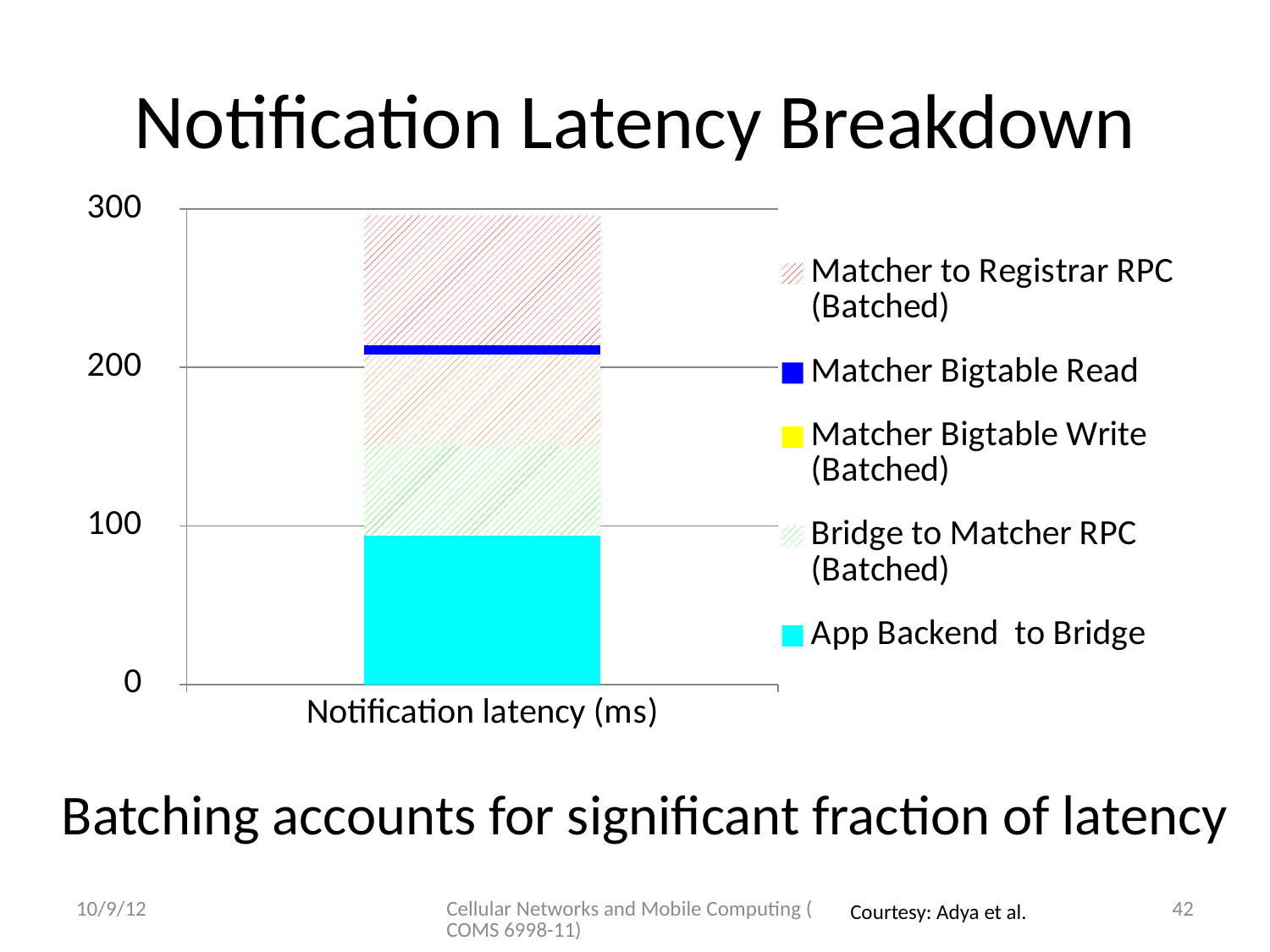
What kind of chart is shown on the slide? Stacked bar chart Which is larger, the App Backend to Bridge segment or the Matcher Bigtable Read segment? App Backend to Bridge Is the cumulative height of the bar up to the top of the Bridge to Matcher RPC (Batched) segment greater or less than 100? greater Is the total height of the stacked bar greater or less than 200? greater Which is larger, the Bridge to Matcher RPC (Batched) segment or the Matcher Bigtable Read segment? Bridge to Matcher RPC (Batched) What is the title of the chart? Notification Latency Breakdown What is the label of the single category on the x axis? Notification latency (ms) Is the value for App Backend to Bridge greater or less than 100? less Which is larger, the Matcher to Registrar RPC (Batched) segment or the Bridge to Matcher RPC (Batched) segment? Matcher to Registrar RPC (Batched) How many series does the legend list? 5 How many categories are plotted on the x axis? 1